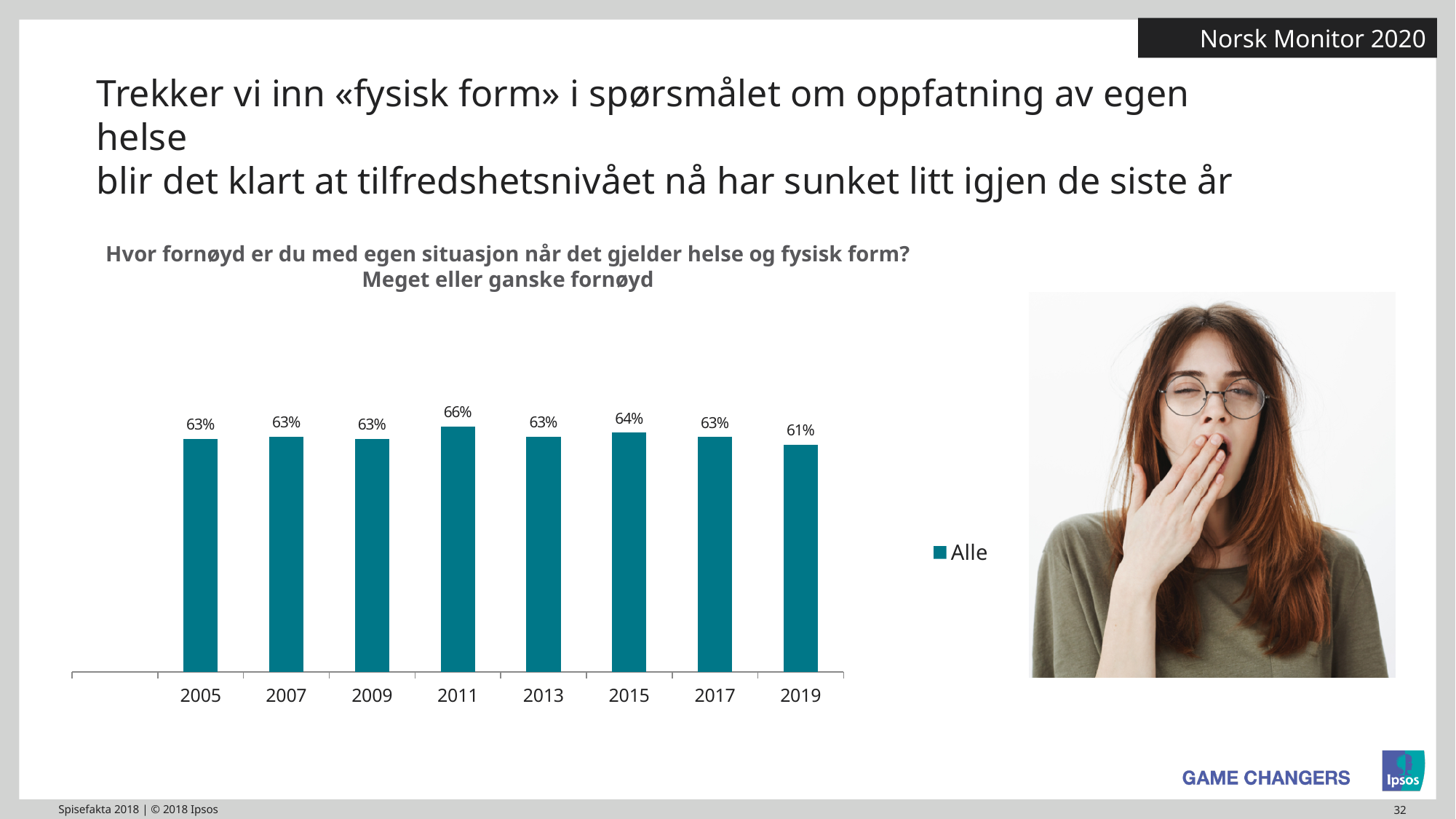
What is the value for 2011? 66% What is the value for 2015? 64% How many years are shown on the x axis? 8 Which is larger, the value for 2015 or the value for 2019? 2015 What is the difference between the values for 2011 and 2019? 5% What is the value for 2019? 61% Which year has the highest value? 2011 How many series does the legend list? 1 What is the value for 2005? 63% Which year has the lowest value? 2019 What is the name of the series in the legend? Alle What kind of chart is shown? Bar chart